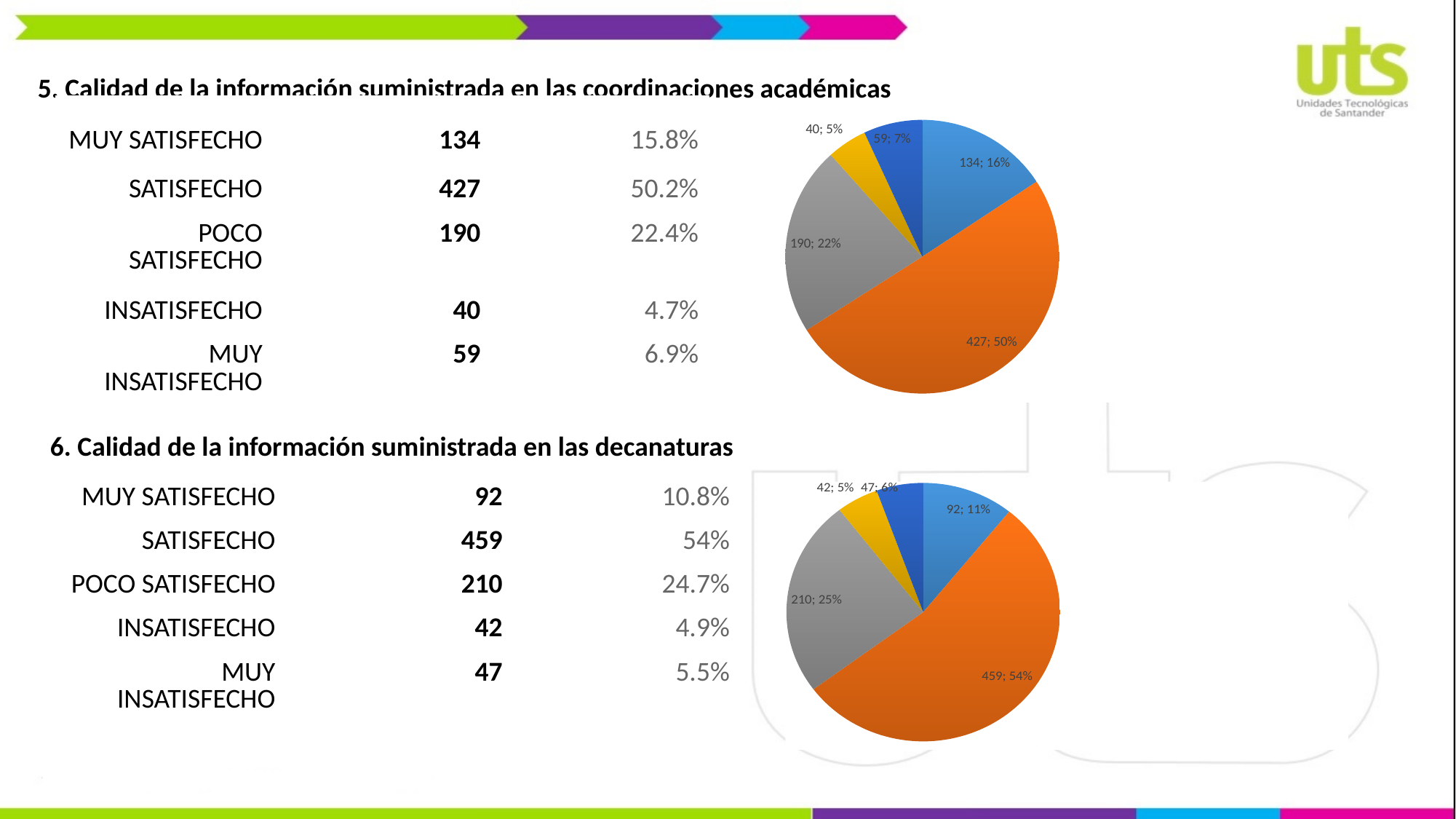
In the top pie chart (coordinaciones académicas), what value is shown on the largest slice? 427 In the top pie chart (coordinaciones académicas), what is the difference between the values of the largest slice (427) and the slice with 134? 293 What kind of chart is used for item 5, 'Calidad de la información suministrada en las coordinaciones académicas'? pie chart How many slices does the top pie chart (coordinaciones académicas) have? 5 In the bottom pie chart (decanaturas), what percentage is shown for the slice with value 459? 54% What colour is the largest slice in the bottom pie chart (decanaturas)? orange In the bottom pie chart (decanaturas), what value is shown on the smallest slice? 42 In the bottom pie chart (decanaturas), which slice is larger: the one with value 210 or the one with value 92? 210 In the bottom pie chart (decanaturas), what percentage is shown for the slice with value 47? 6% How many slices does the bottom pie chart (decanaturas) have? 5 In the top pie chart (coordinaciones académicas), what percentage is shown for the slice with value 190? 22% In the top pie chart (coordinaciones académicas), what value is shown on the smallest slice? 40